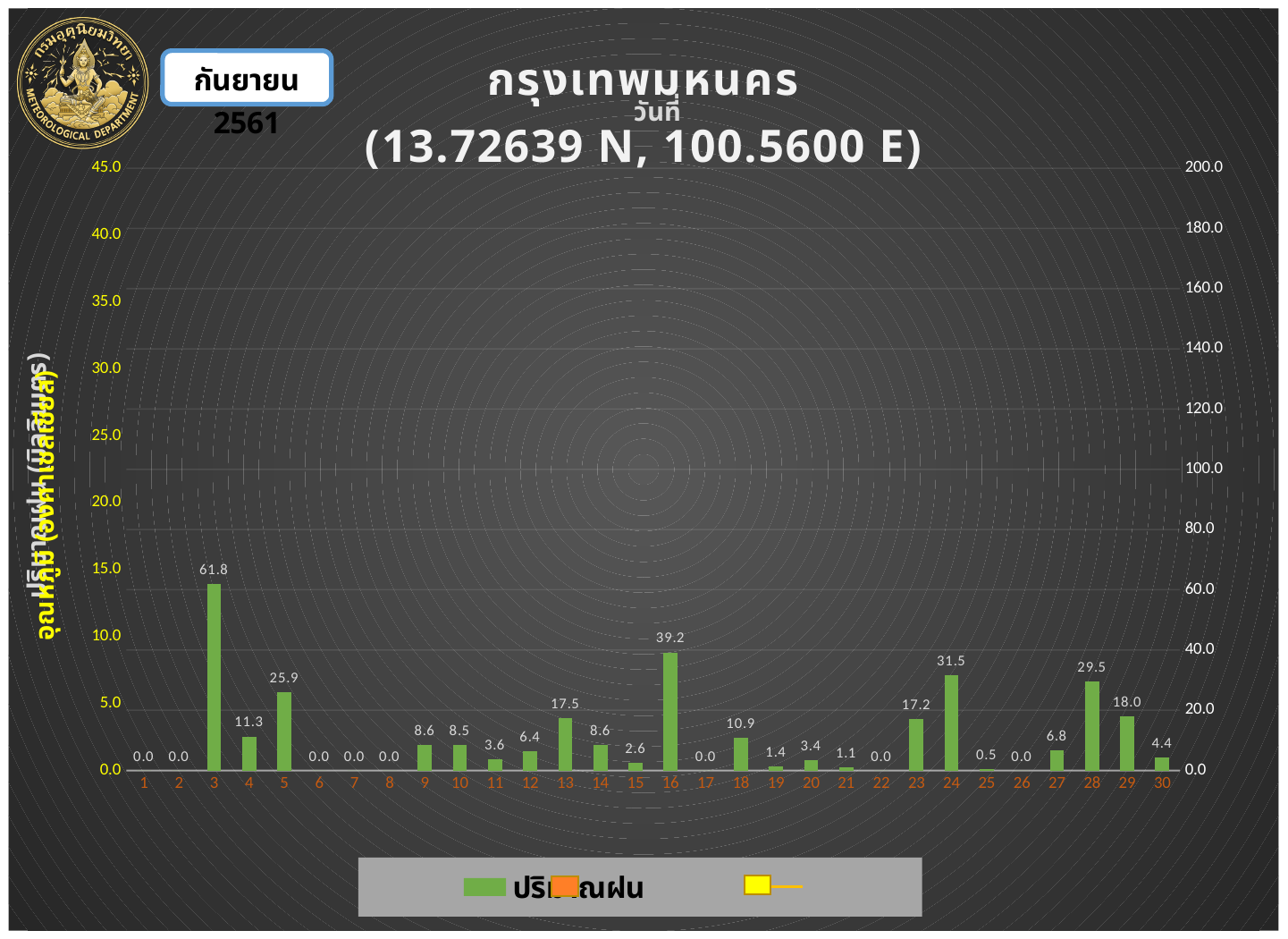
Which is larger, the value for day 5 or the value for day 13? day 5 Which day has the highest value? 3 What is the difference between the values for day 24 and day 28? 2.0 What is the value for day 28? 29.5 Which is larger, the value for day 29 or the value for day 23? day 29 How many days are shown on the x axis? 30 What is the value for day 16? 39.2 What is the value for day 3? 61.8 What is the value for day 24? 31.5 What is the difference between the values for day 3 and day 16? 22.6 What colour are the bars in the chart? green What kind of chart is shown on the slide? bar chart